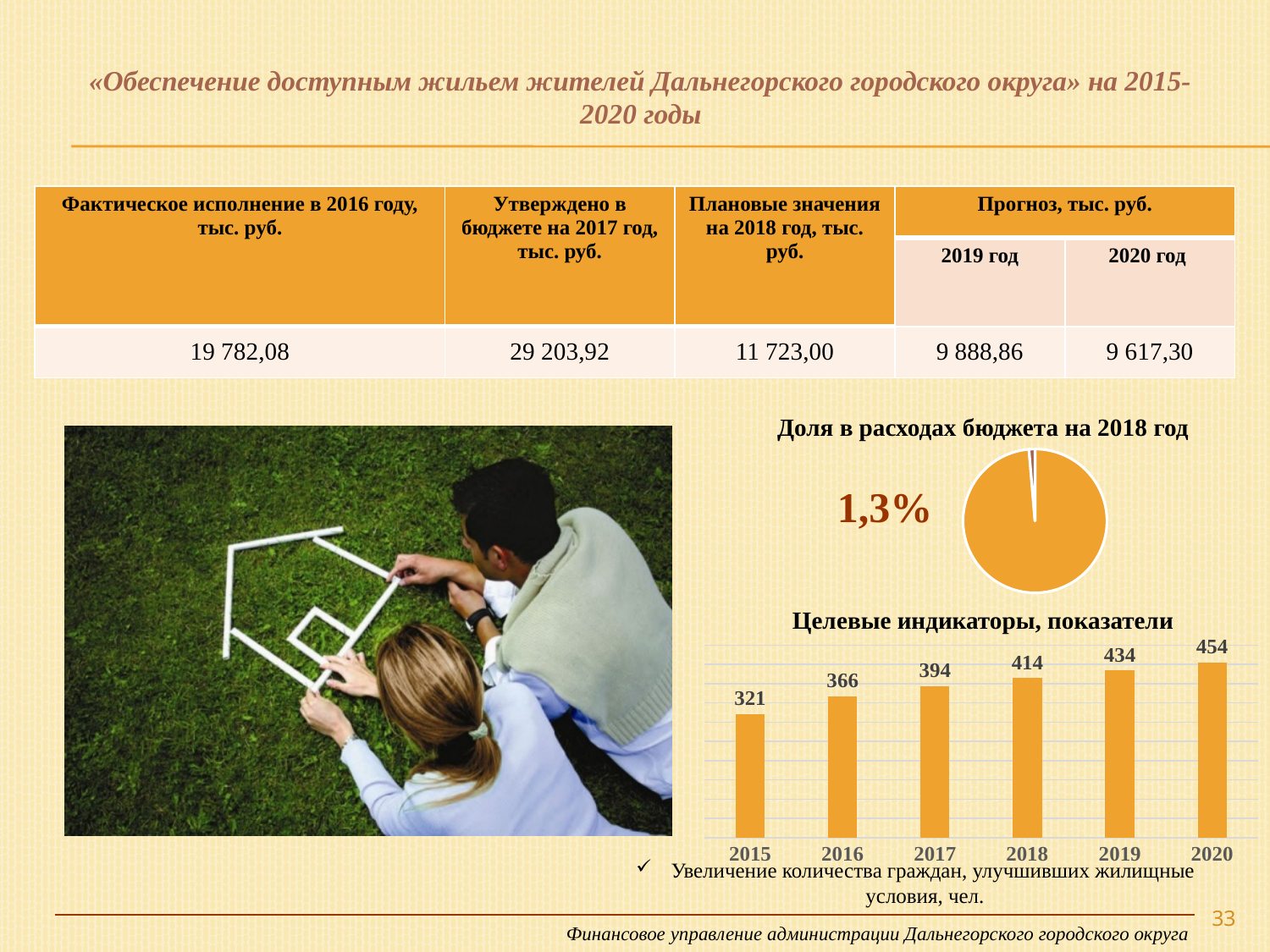
In the bar chart 'Целевые индикаторы, показатели', what is the value for 2020? 454 In the bar chart 'Целевые индикаторы, показатели', what is the value for 2015? 321 In the bar chart 'Целевые индикаторы, показатели', which year has the highest value? 2020 In the bar chart 'Целевые индикаторы, показатели', do the values rise or fall from 2015 to 2020? rise In the bar chart 'Целевые индикаторы, показатели', which year has the lowest value? 2015 In the bar chart 'Целевые индикаторы, показатели', what is the value for 2018? 414 How many years are shown in the bar chart 'Целевые индикаторы, показатели'? 6 What type of chart is 'Целевые индикаторы, показатели'? bar chart In the bar chart 'Целевые индикаторы, показатели', what is the difference between the values for 2020 and 2015? 133 In the bar chart 'Целевые индикаторы, показатели', what is the difference between the values for 2017 and 2016? 28 In the pie chart 'Доля в расходах бюджета на 2018 год', what share is shown for the programme? 1,3% In the bar chart 'Целевые индикаторы, показатели', which is larger, the value for 2016 or the value for 2019? 2019